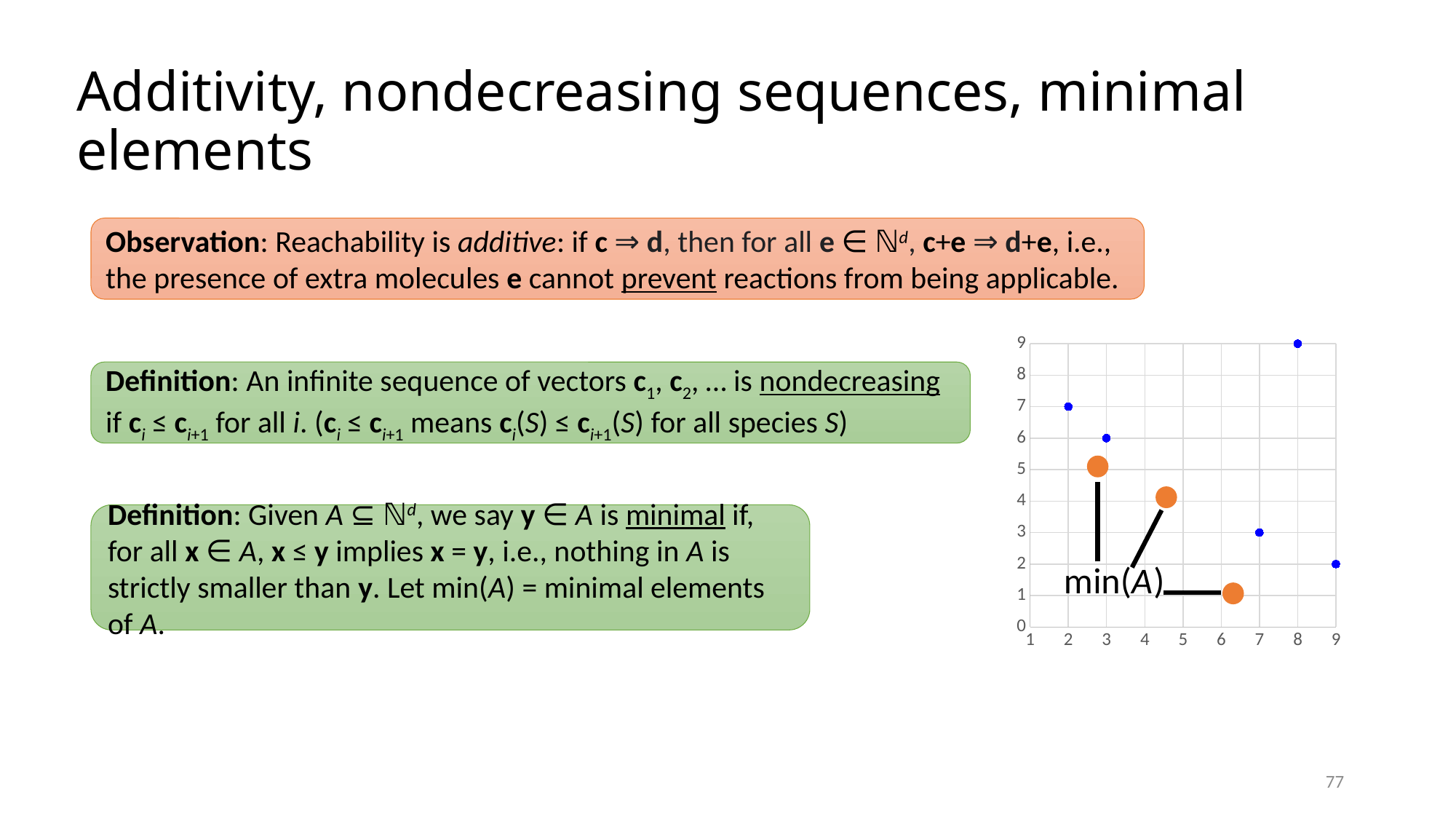
Which blue point has the lowest y value? the point at x = 9 (y = 2) How many blue points are plotted on the chart? 5 What kind of chart is shown on the right of the slide? scatter chart Is the y value of the blue point at x = 2 larger than the y value of the blue point at x = 7? yes Is the y value of the orange point nearest x = 6 greater or less than 3? less What is the y value of the blue point at x = 2? 7 Which blue point has the highest y value? the point at x = 8 (y = 9) What label is written next to the orange points on the chart? min(A) What is the y value of the blue point at x = 3? 6 What is the y value of the blue point at x = 7? 3 What is the y value of the blue point at x = 9? 2 How many orange points are plotted on the chart? 3